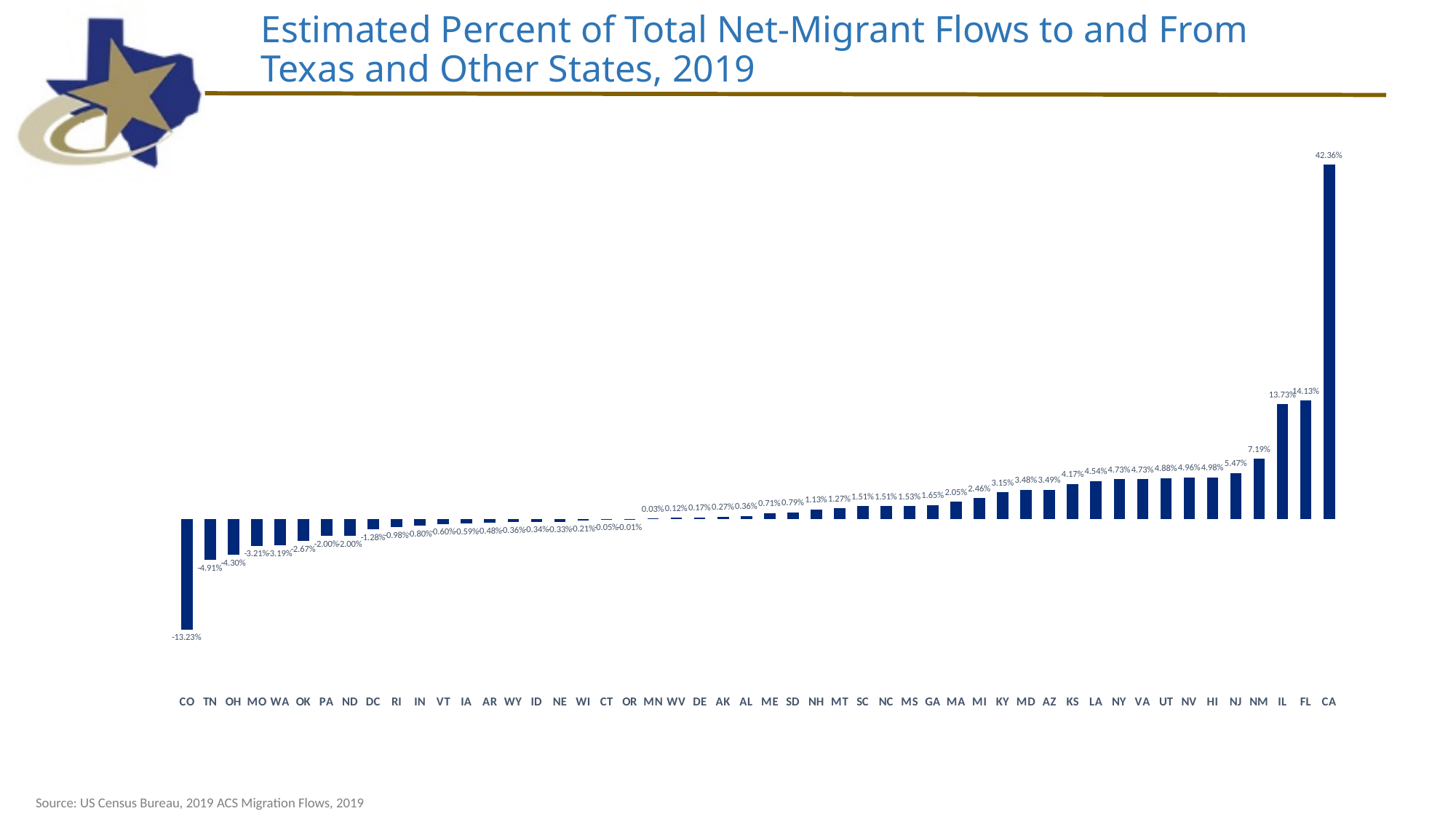
What is the value for CA? 42.36% What kind of chart is this? Bar chart Which state has the highest value? CA Which is larger, the value for IL or the value for FL? FL How many states are shown on the x axis? 50 What is the value for TN? -4.91% Do the values rise or fall from left to right along the x axis? Rise Which state has the lowest value? CO What is the difference between the values for FL and IL? 0.40% What is the value for NM? 7.19% What is the value for CO? -13.23% What is the difference between the values for CA and FL? 28.23%